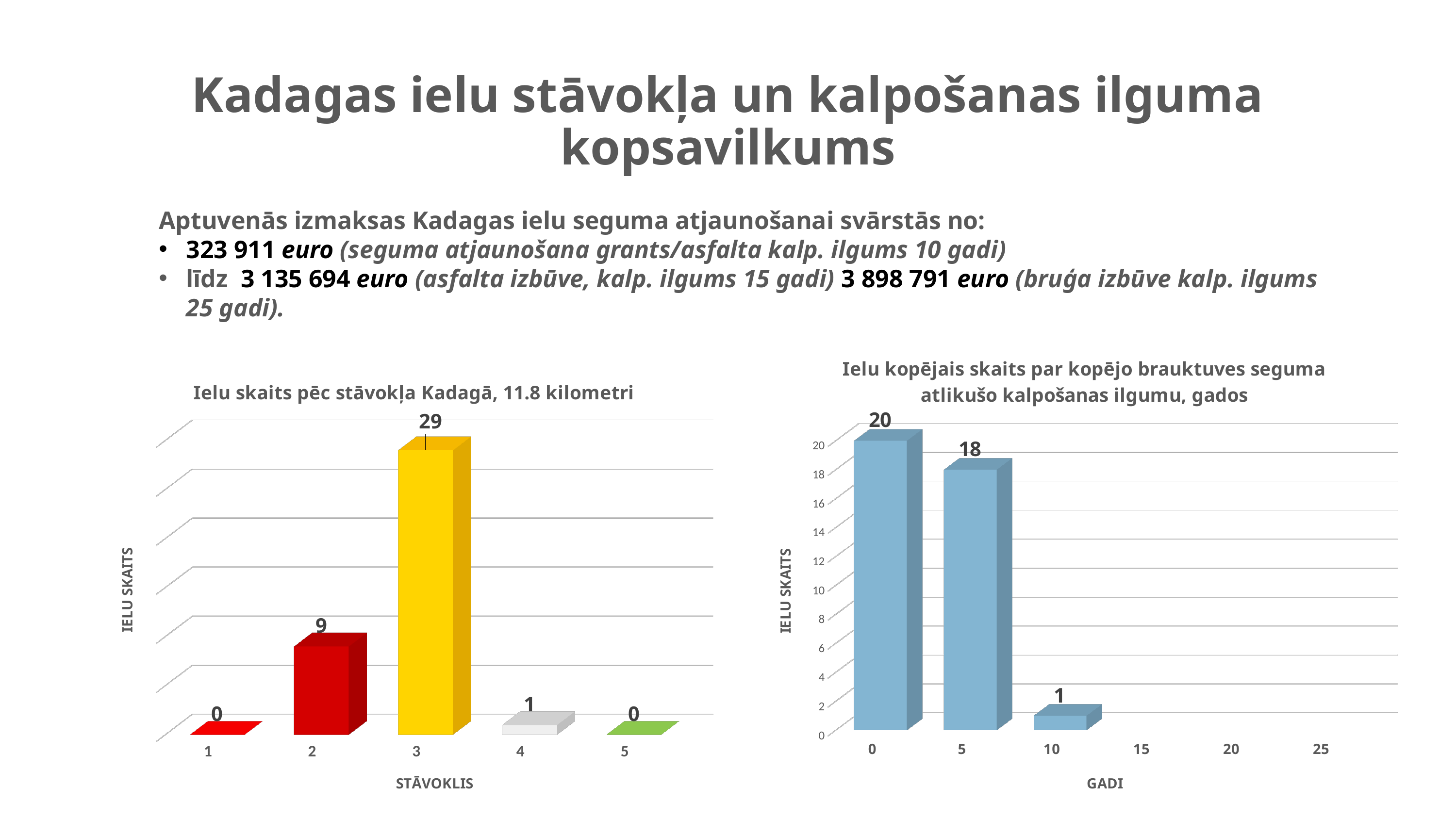
In the right chart 'Ielu kopējais skaits par kopējo brauktuves seguma atlikušo kalpošanas ilgumu, gados', what is the value for 10 years? 1 In the right chart 'Ielu kopējais skaits par kopējo brauktuves seguma atlikušo kalpošanas ilgumu, gados', what is the difference between the values for 5 years and 10 years? 17 In the left chart 'Ielu skaits pēc stāvokļa Kadagā, 11.8 kilometri', what is the value for condition (stāvoklis) 3? 29 What kind of chart is the right chart 'Ielu kopējais skaits par kopējo brauktuves seguma atlikušo kalpošanas ilgumu, gados'? Bar chart In the left chart 'Ielu skaits pēc stāvokļa Kadagā, 11.8 kilometri', what is the difference between the values for condition 3 and condition 2? 20 In the right chart 'Ielu kopējais skaits par kopējo brauktuves seguma atlikušo kalpošanas ilgumu, gados', do the values rise or fall from 0 years to 10 years? Fall In the left chart 'Ielu skaits pēc stāvokļa Kadagā, 11.8 kilometri', how many condition categories are shown on the x axis? 5 In the left chart 'Ielu skaits pēc stāvokļa Kadagā, 11.8 kilometri', what is the value for condition 2? 9 In the left chart 'Ielu skaits pēc stāvokļa Kadagā, 11.8 kilometri', which condition category has the highest number of streets? 3 In the left chart 'Ielu skaits pēc stāvokļa Kadagā, 11.8 kilometri', what colour is the bar for condition 3? Yellow In the right chart 'Ielu kopējais skaits par kopējo brauktuves seguma atlikušo kalpošanas ilgumu, gados', what is the value for 0 years (gadi)? 20 In the right chart 'Ielu kopējais skaits par kopējo brauktuves seguma atlikušo kalpošanas ilgumu, gados', which is larger, the value for 0 years or the value for 5 years? 0 years